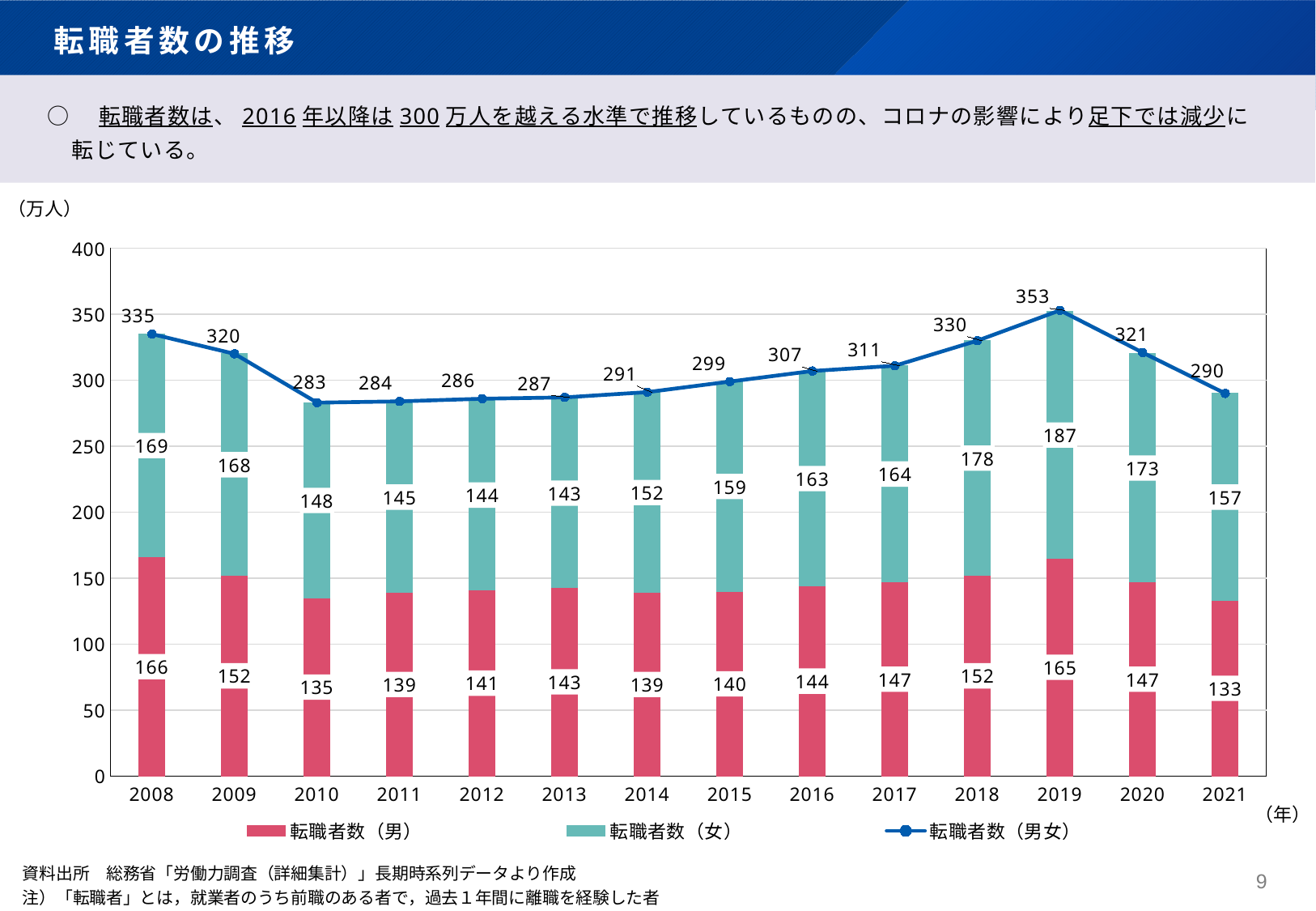
Which is larger, 転職者数（女） in 2018 or in 2020? 2018 What is the value of 転職者数（男） for 2008? 166 What kind of chart is shown on the slide? Stacked bar chart with a line In which year is 転職者数（男女） lowest? 2010 What is the value of 転職者数（女） for 2021? 157 In which year is 転職者数（男女） highest? 2019 How many years are shown on the x axis? 14 Is the value of 転職者数（男女） for 2014 greater or less than 300? less Does 転職者数（男女） rise or fall from 2010 to 2019? rise How many series does the legend list? 3 What is the value of 転職者数（男女） for 2019? 353 What is the difference between 転職者数（男女） in 2019 and 2021? 63